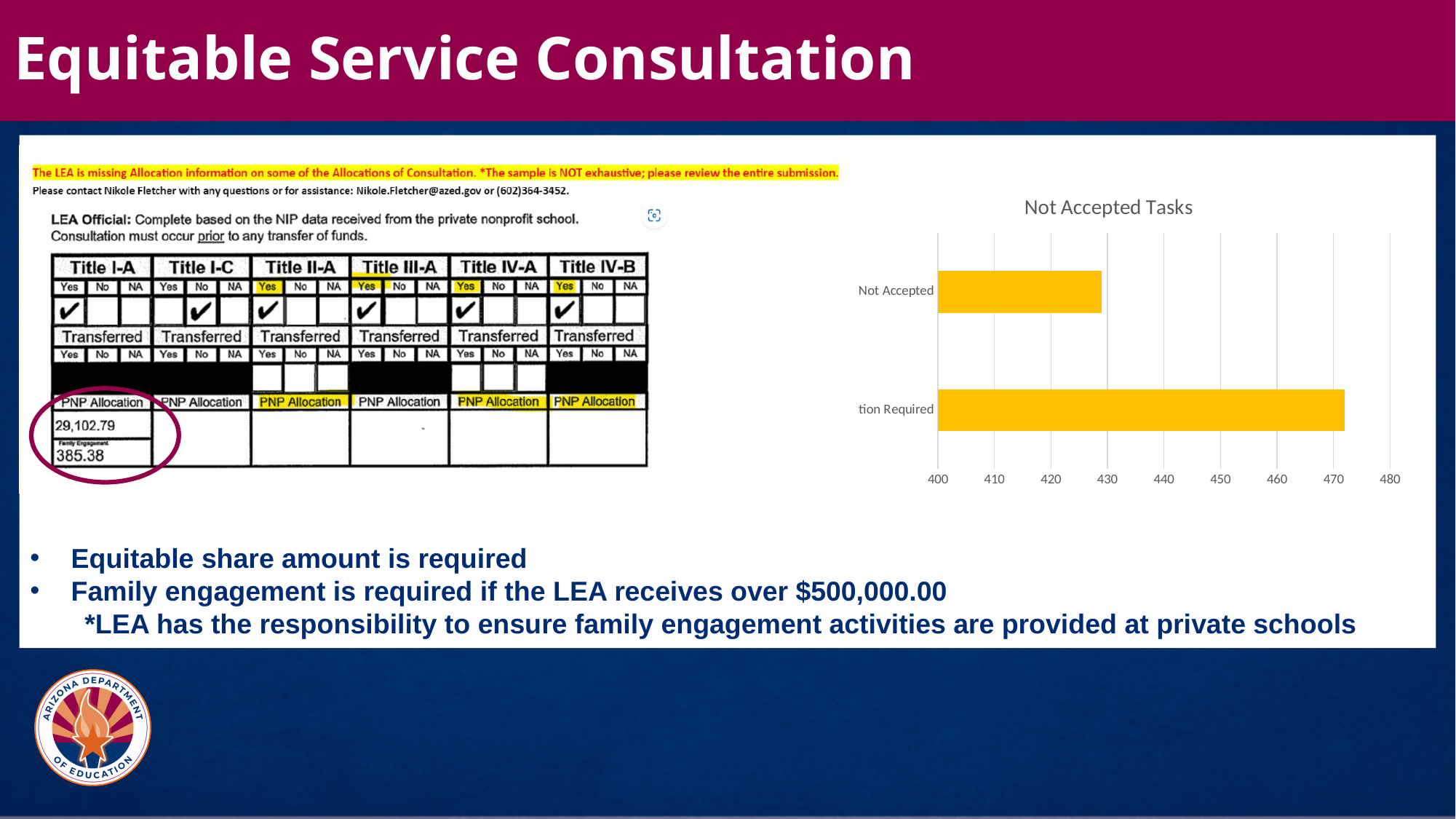
In the 'Not Accepted Tasks' chart, which bar is longer: the Not Accepted bar or the lower bar whose label ends in 'tion Required'? the lower bar (ending in 'tion Required') What is the lowest value shown on the horizontal axis of the 'Not Accepted Tasks' chart? 400 How many bars are plotted in the 'Not Accepted Tasks' chart? 2 In the 'Not Accepted Tasks' chart, is the value for Not Accepted greater or less than 440? less In the 'Not Accepted Tasks' chart, is the value of the lower bar (the one whose label ends in 'tion Required') greater or less than 480? less What is the highest value shown on the horizontal axis of the 'Not Accepted Tasks' chart? 480 In the 'Not Accepted Tasks' chart, is the Not Accepted bar the longest or the shortest of the bars? shortest In the 'Not Accepted Tasks' chart, is the value for Not Accepted greater or less than 420? greater What kind of chart is the 'Not Accepted Tasks' chart? bar chart What is the title of the chart on the right side of the slide? Not Accepted Tasks